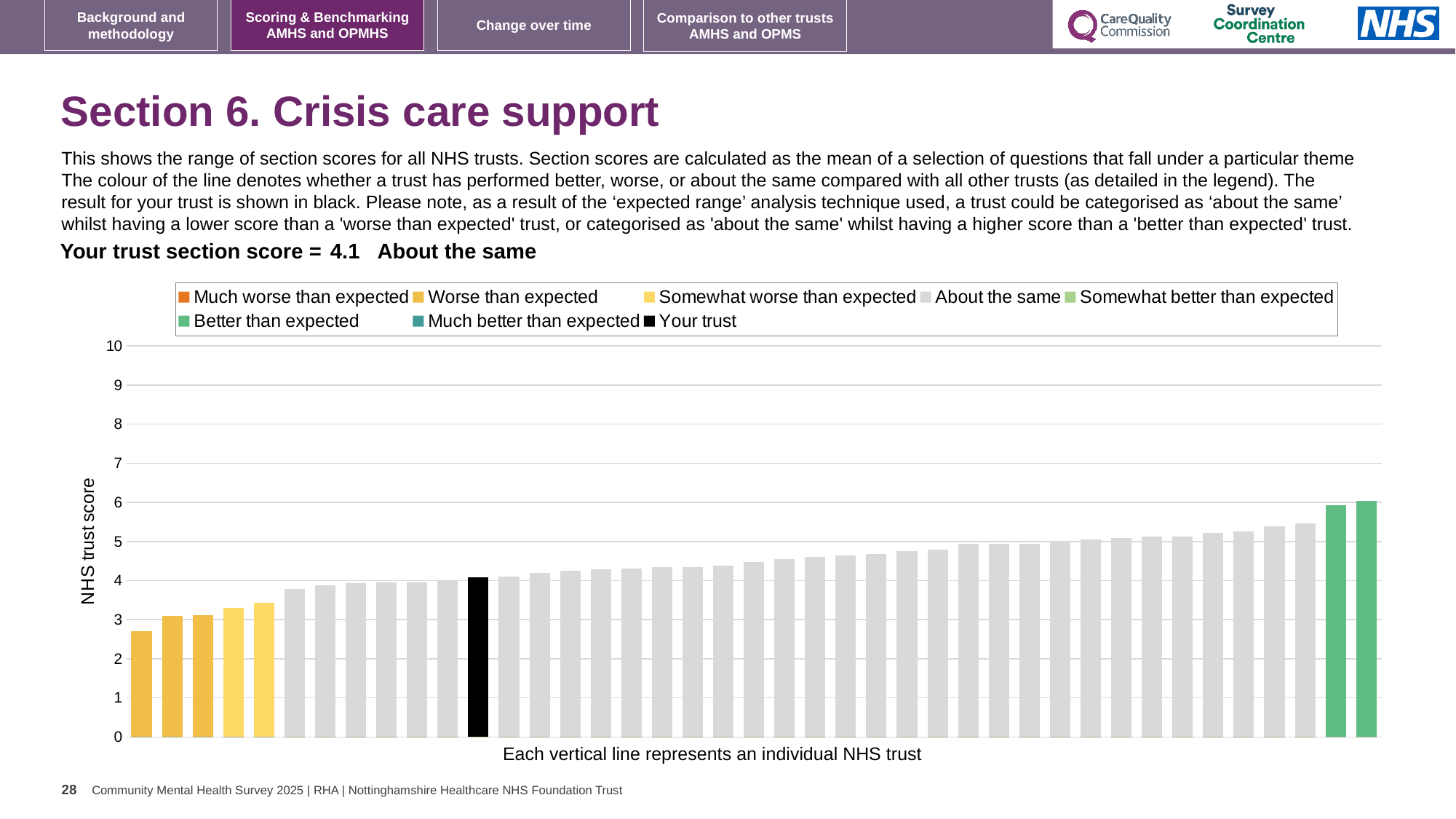
What kind of chart is shown on the slide? bar chart How many bars are coloured as 'Worse than expected' (gold)? 3 Do the bar values rise or fall from left to right along the x axis? rise How many bars are coloured as 'Better than expected' (green)? 2 Is the value of the highest bar in the chart greater or less than 5? greater Which legend category do the highest bars in the chart belong to? Better than expected What is the label on the vertical axis of the chart? NHS trust score Is the value for your trust (the black bar) greater or less than 4? greater Is the value of the highest bar in the chart greater or less than 7? less What is the section score for your trust shown on the slide? 4.1 How many entries does the chart legend list? 8